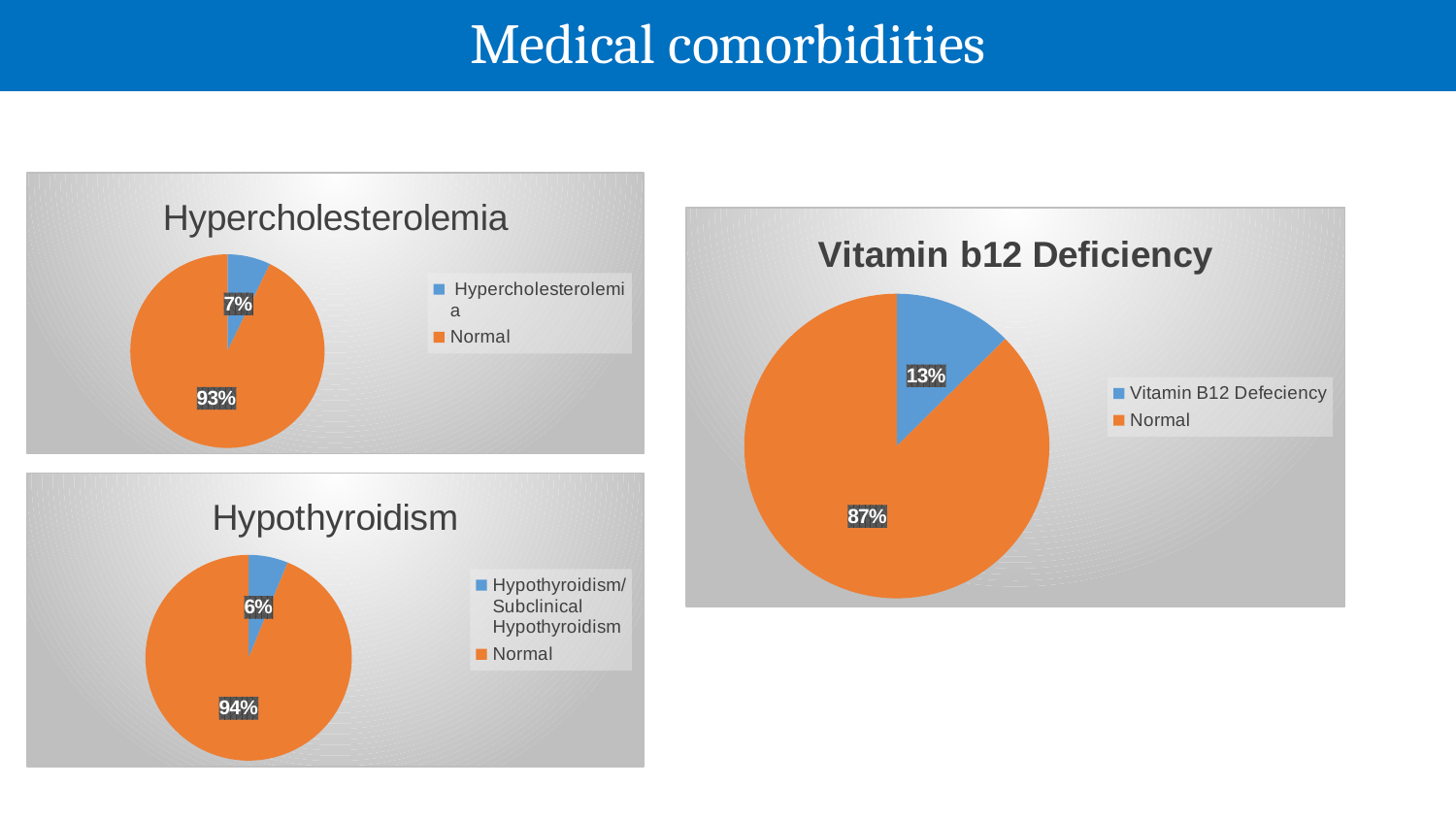
In the Hypothyroidism chart, what share of the pie is Hypothyroidism/Subclinical Hypothyroidism? 6% In the Hypercholesterolemia chart, what is the difference between the Normal share and the Hypercholesterolemia share? 86% In the Hypercholesterolemia chart, what share of the pie is labelled Hypercholesterolemia? 7% In the Vitamin b12 Deficiency chart, what share of the pie is Vitamin B12 Defeciency? 13% In the Hypothyroidism chart, which slice is the smallest? Hypothyroidism/Subclinical Hypothyroidism How many entries does the legend of the Vitamin b12 Deficiency chart list? 2 What kind of chart is the Vitamin b12 Deficiency chart? Pie chart How many slices does the Hypothyroidism pie chart have? 2 In the Vitamin b12 Deficiency chart, which slice is larger, Vitamin B12 Defeciency or Normal? Normal